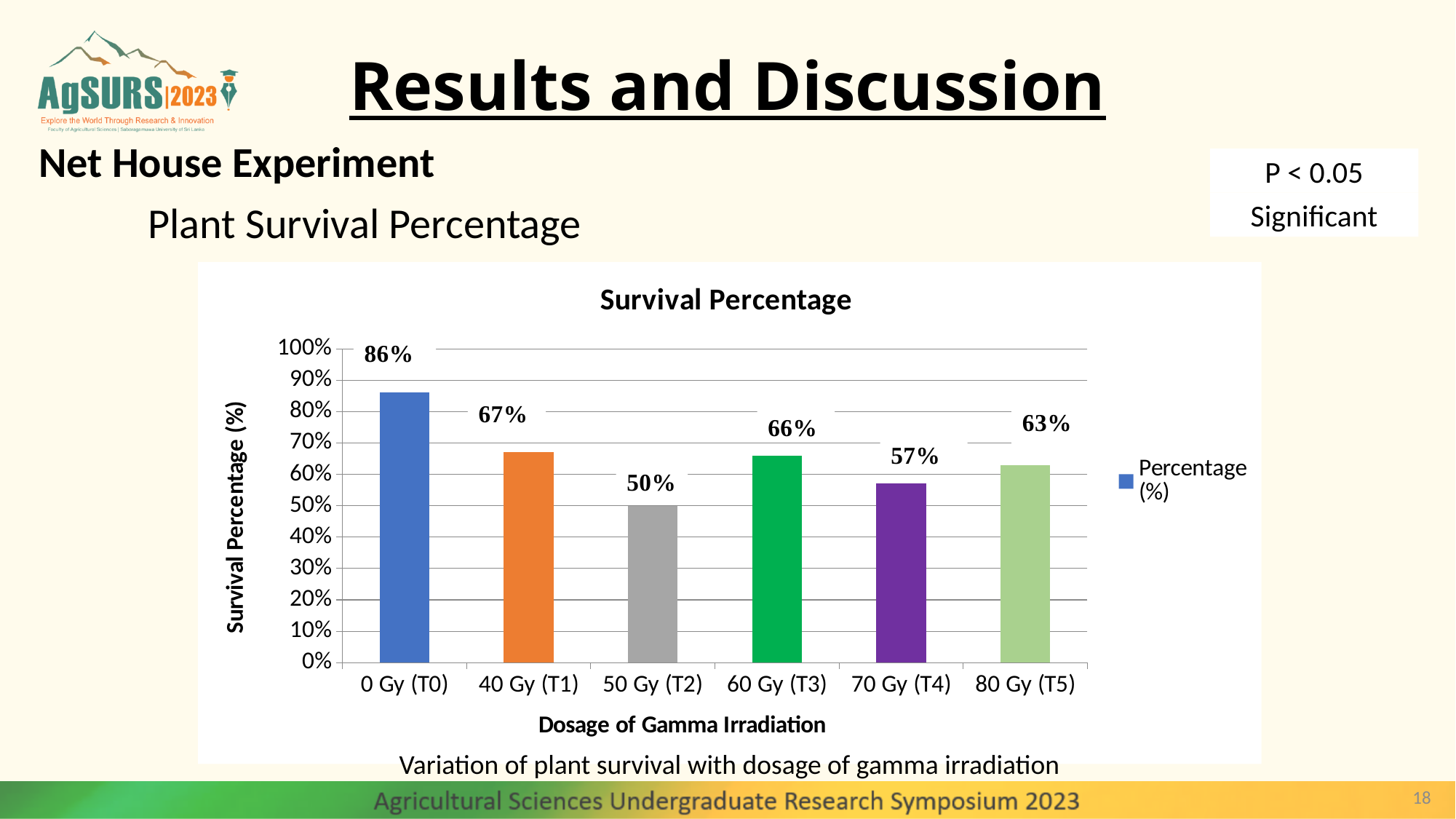
Which dosage has the highest survival percentage? 0 Gy (T0) What is the survival percentage for 50 Gy (T2)? 50% How many dosage categories are shown on the x axis? 6 Is the survival percentage for 70 Gy (T4) greater or less than 60%? less Which dosage has the lowest survival percentage? 50 Gy (T2) Which has a higher survival percentage, 40 Gy (T1) or 60 Gy (T3)? 40 Gy (T1) What is the title of the chart? Survival Percentage How many series does the legend list? 1 What is the survival percentage for 70 Gy (T4)? 57% What is the difference in survival percentage between 0 Gy (T0) and 80 Gy (T5)? 23% What kind of chart is shown on the slide? bar chart What is the survival percentage for 0 Gy (T0)? 86%